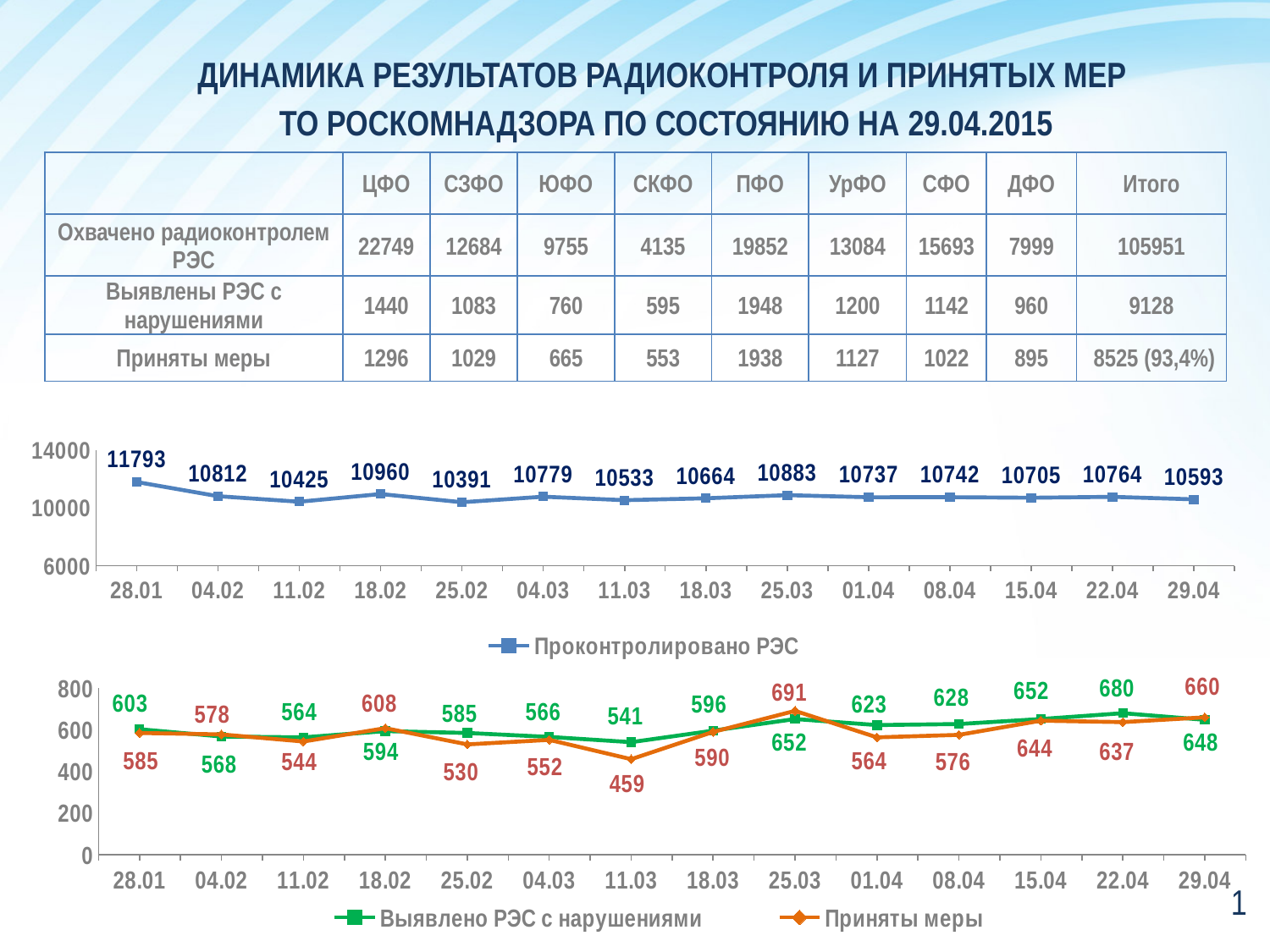
In the bottom chart, what is the value of Выявлено РЭС с нарушениями for 22.04? 680 In the top chart (Проконтролировано РЭС), what is the difference between the values for 28.01 and 04.02? 981 How many series does the legend of the bottom chart list? 2 In the top chart (Проконтролировано РЭС), what is the value for 29.04? 10593 In the bottom chart, on which date does Приняты меры reach its highest value? 25.03 In the top chart (Проконтролировано РЭС), which date has the highest value? 28.01 In the bottom chart, what is the value of Приняты меры for 11.03? 459 What type of chart is the bottom chart? Line chart In the bottom chart, which is larger for 25.03: Выявлено РЭС с нарушениями or Приняты меры? Приняты меры How many data points are plotted in the top chart (Проконтролировано РЭС)? 14 In the top chart (Проконтролировано РЭС), which date has the lowest value? 25.02 In the top chart (Проконтролировано РЭС), what is the value for 28.01? 11793